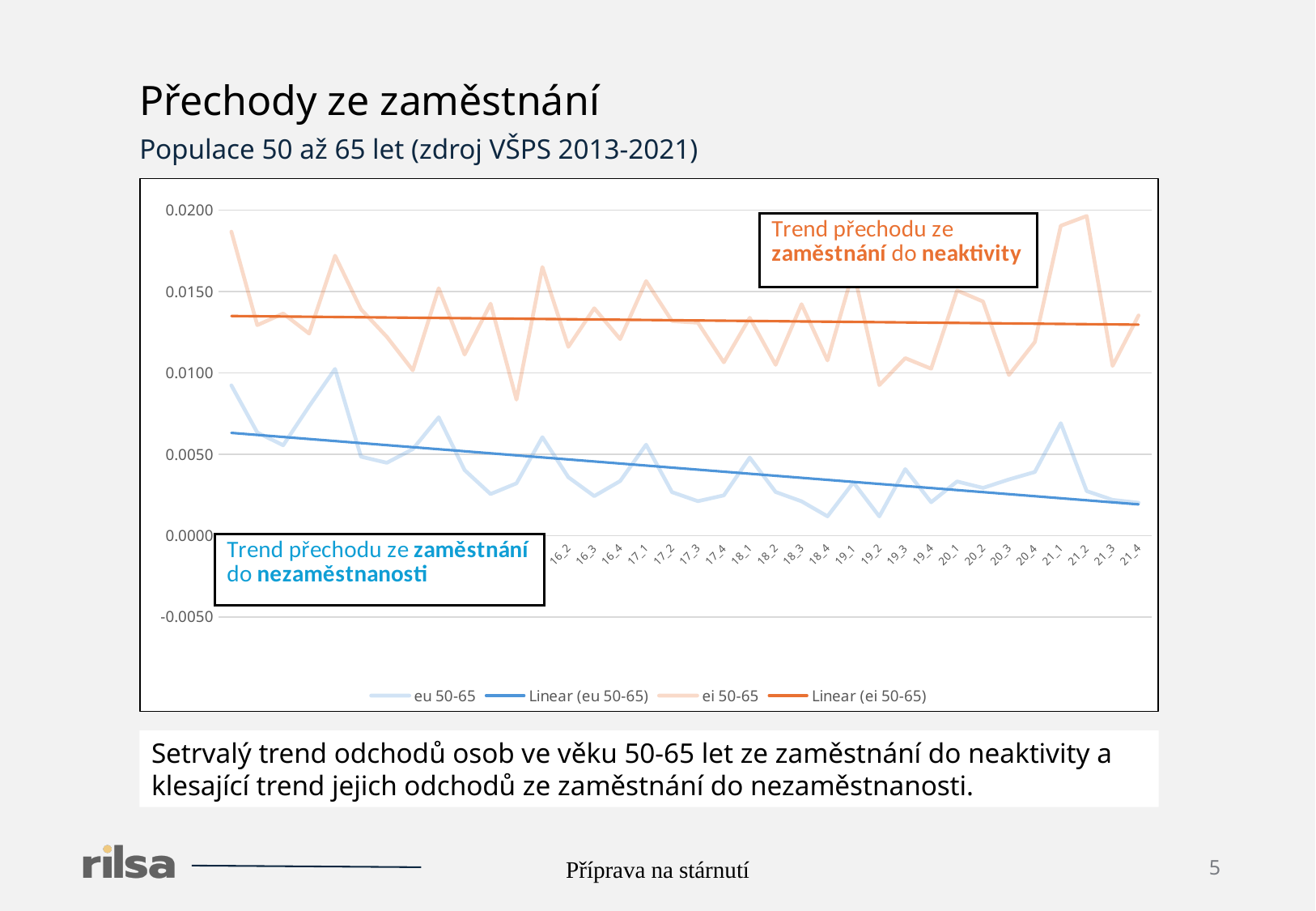
How many series does the chart legend list? 4 Which series is higher at 21_4, ei 50-65 or eu 50-65? ei 50-65 Is the value of eu 50-65 at 21_1 greater or less than 0.0050? greater Is the value of ei 50-65 at 17_3 greater or less than 0.0100? greater Which series lies higher on the chart overall, ei 50-65 or eu 50-65? ei 50-65 Is the value of eu 50-65 at 21_4 greater or less than 0.0050? less What are the four series listed in the chart legend? eu 50-65, Linear (eu 50-65), ei 50-65, Linear (ei 50-65) What is the subtitle of the chart slide describing the population and data source? Populace 50 až 65 let (zdroj VŠPS 2013-2021) At which x-axis point does the ei 50-65 series reach its highest value? 21_2 What kind of chart is shown on the slide? line chart Does the Linear (eu 50-65) trend line rise or fall from left to right? fall